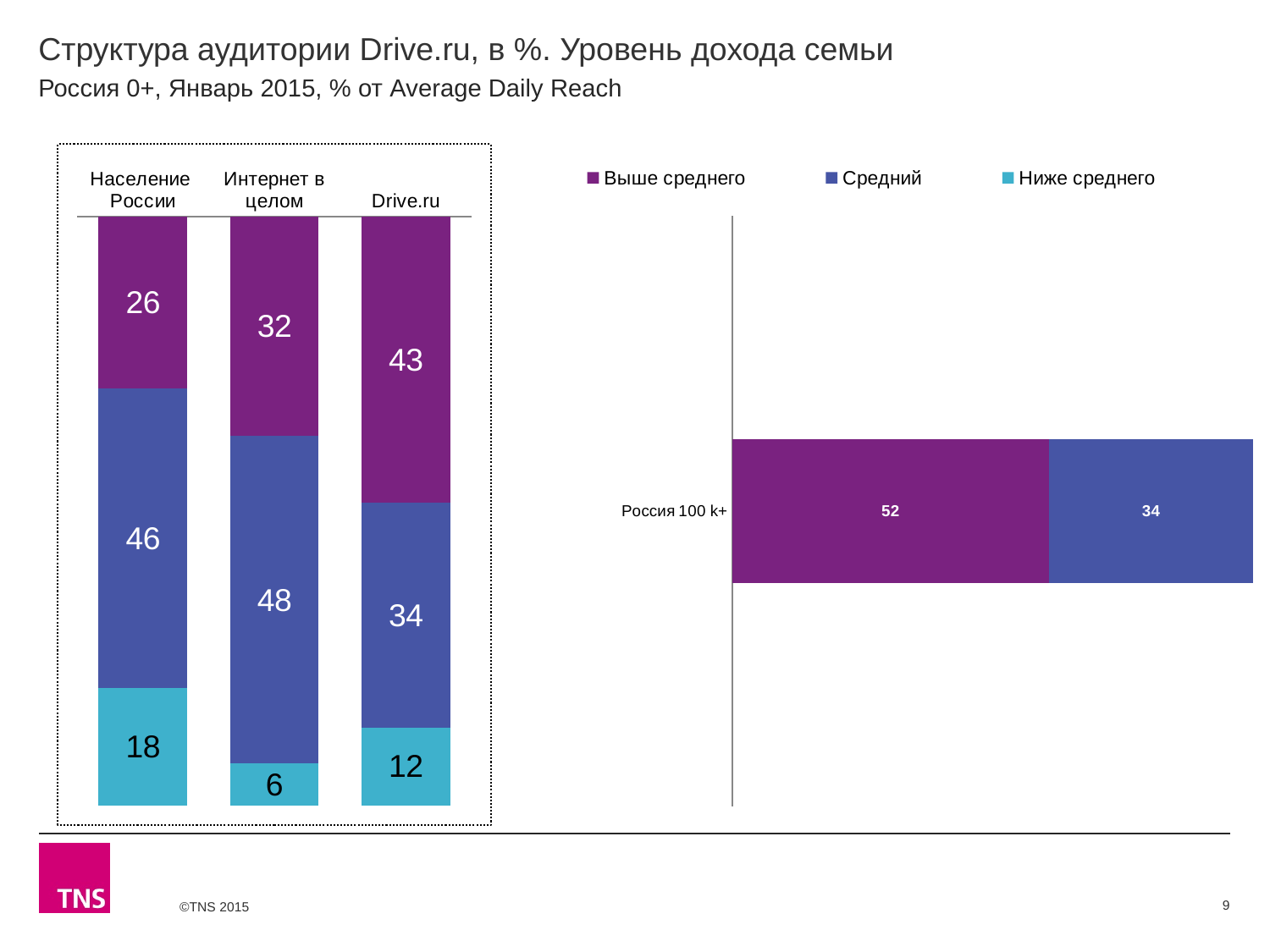
How many categories are shown on the x axis of the left chart? 3 In the left chart, what is the value of the Средний segment for Интернет в целом? 48 How many series does the legend list? 3 In the left chart, which category has the lowest Ниже среднего value? Интернет в целом In the left chart, what is the value of the Ниже среднего segment for Население России? 18 In the right chart, what is the total of the two labelled segments for Россия 100 k+? 86 In the left chart, which is larger: the Средний value for Drive.ru or the Средний value for Население России? Население России In the left chart, what is the value of the Выше среднего segment for Drive.ru? 43 What type of chart is the right chart? Stacked bar chart In the left chart, what is the difference between the Выше среднего values for Drive.ru and Население России? 17 In the right chart, what is the value of the Выше среднего segment for Россия 100 k+? 52 In the left chart, which category has the highest Выше среднего value? Drive.ru